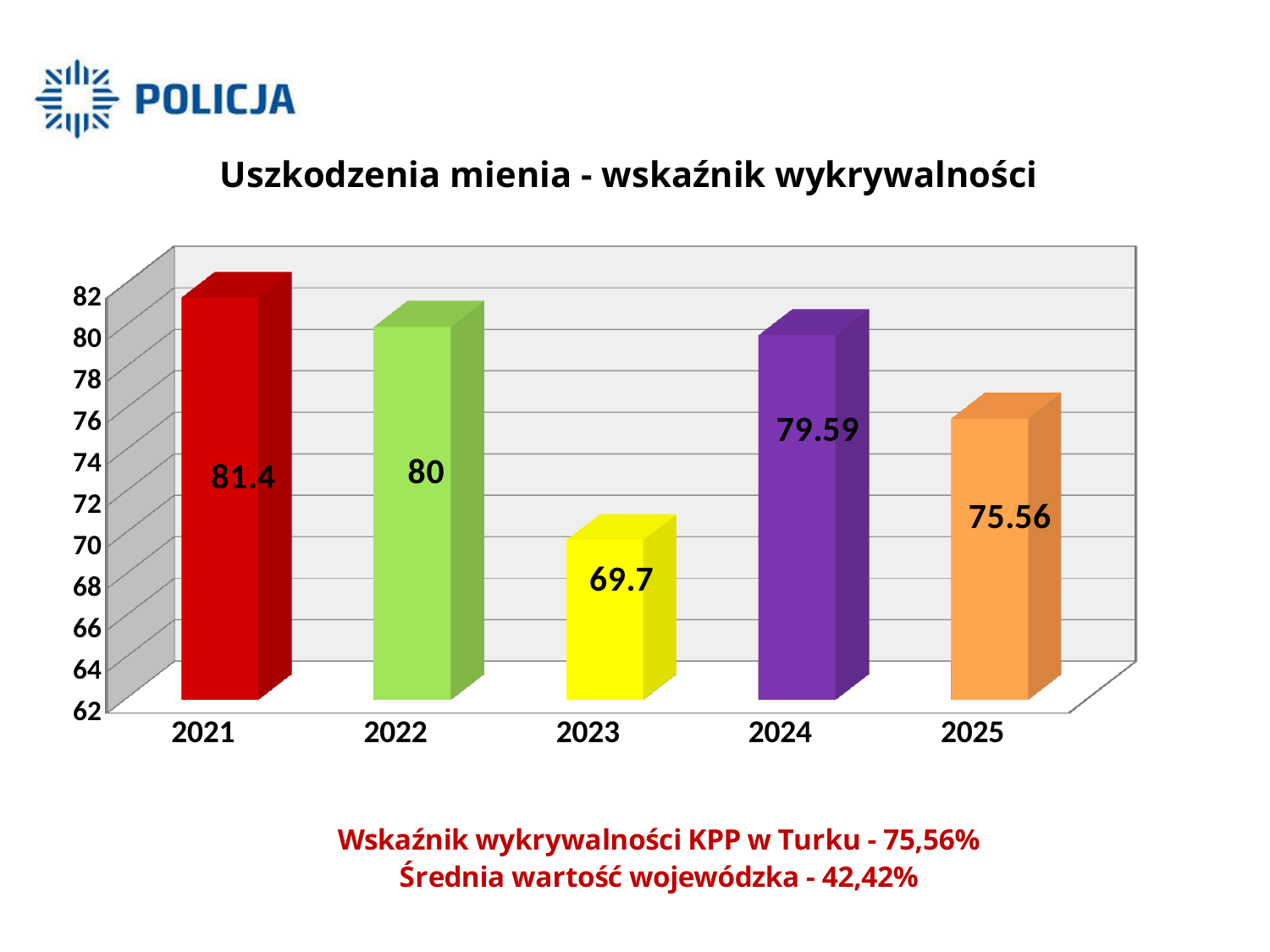
What is the value for 2023? 69.7 What kind of chart is this? bar chart What is the title of the chart? Uszkodzenia mienia - wskaźnik wykrywalności Which year has the highest value? 2021 What is the difference between the values for 2021 and 2023? 11.7 What is the value for 2024? 79.59 What is the value for 2025? 75.56 What is the value for 2021? 81.4 Which is larger, the value for 2022 or the value for 2025? 2022 How many years are shown on the x axis? 5 Which year has the lowest value? 2023 Is the value for 2024 greater or less than 78? greater